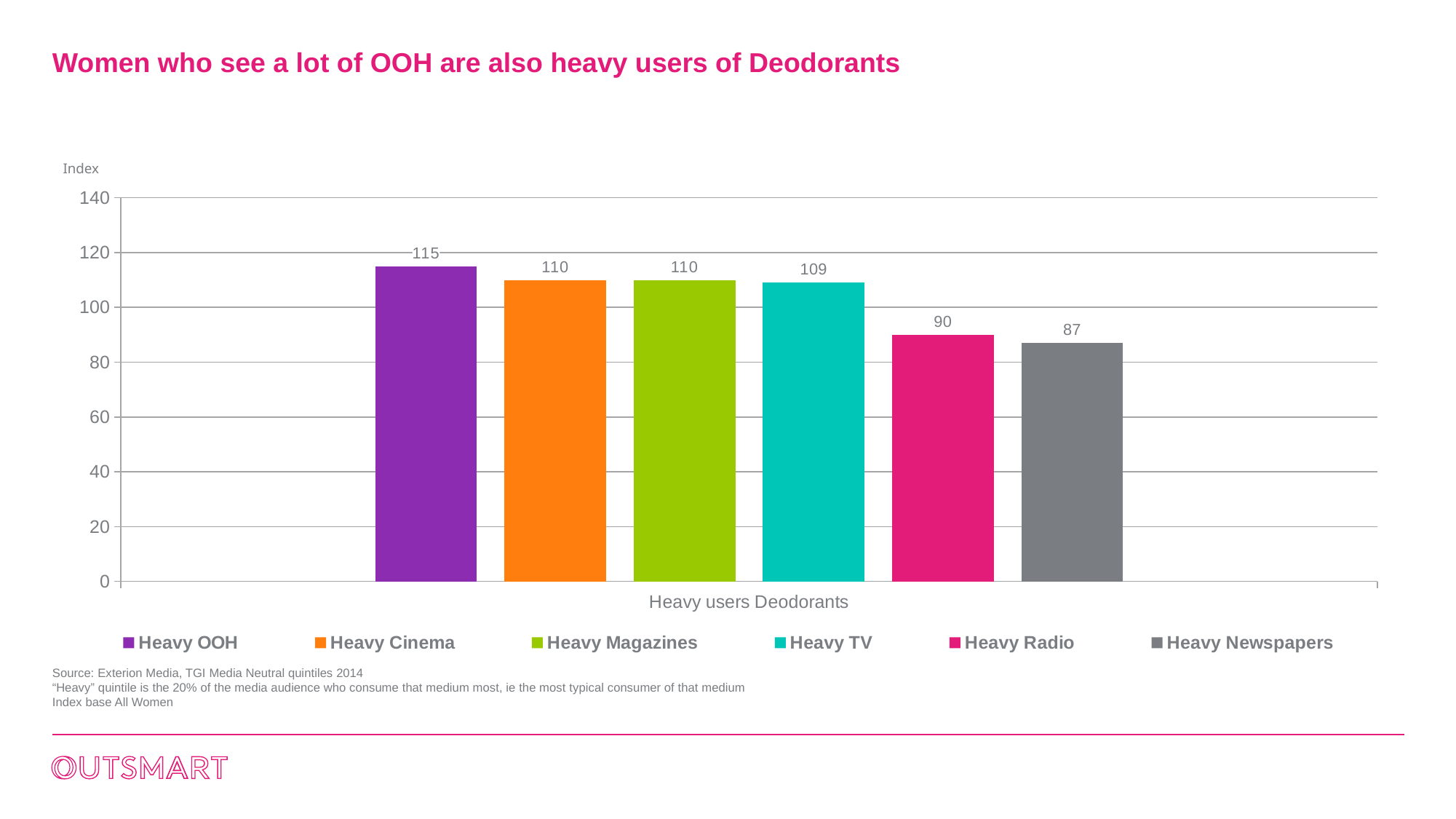
What kind of chart is shown on the slide? bar chart Is the index value for Heavy Radio greater or less than 100? less What is the difference between the index values for Heavy OOH and Heavy Radio? 25 How many series does the legend list? 6 What is the index value for Heavy Newspapers? 87 Which series has the highest index value? Heavy OOH What is the index value for Heavy TV? 109 Which series has the lowest index value? Heavy Newspapers Which is larger, the index value for Heavy Cinema or Heavy Radio? Heavy Cinema What is the index value for Heavy OOH? 115 What colour is the bar for Heavy Magazines? green What is the category label shown on the x axis? Heavy users Deodorants